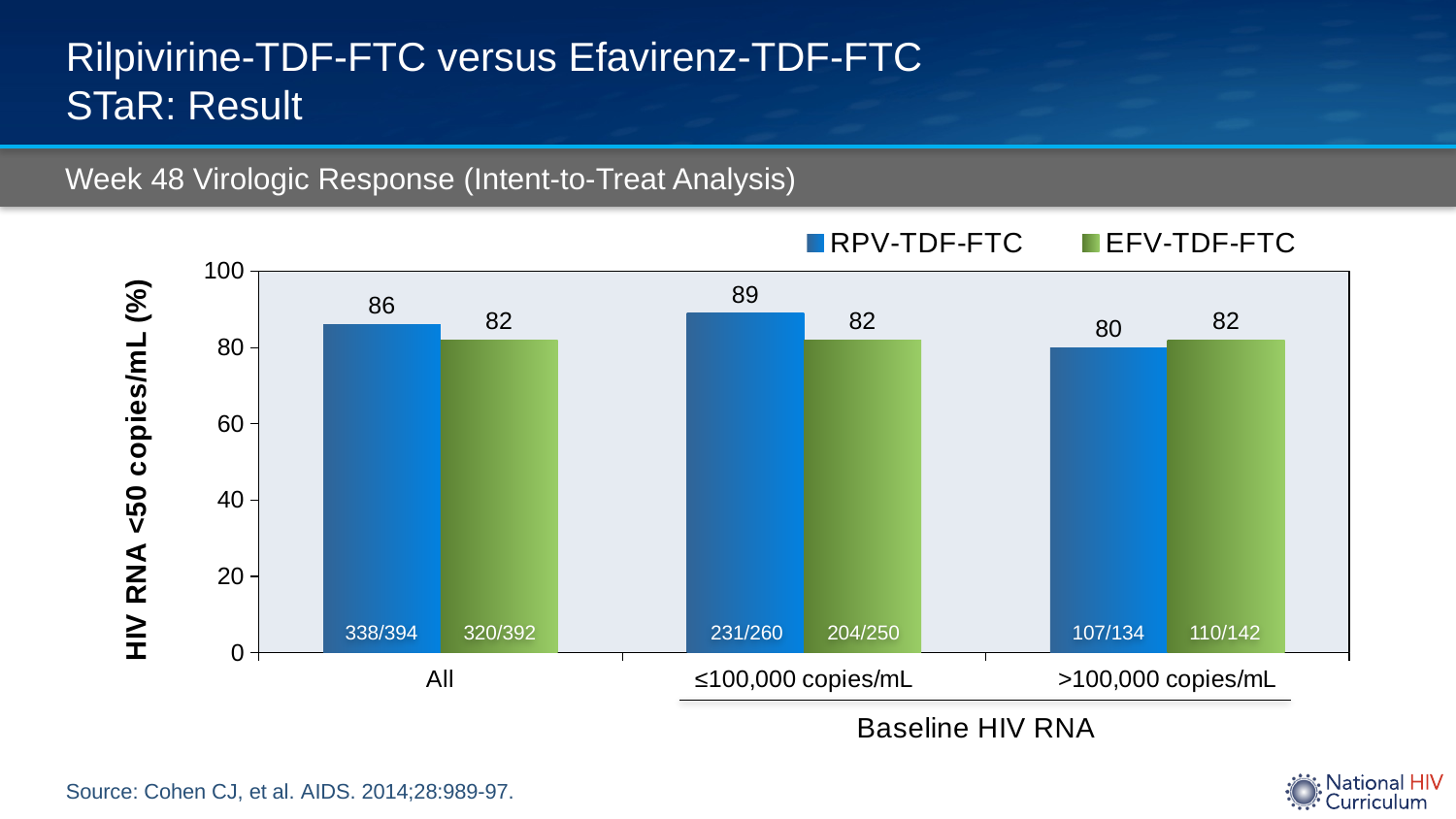
How many series does the legend list? 2 Which category has the lowest value for RPV-TDF-FTC? >100,000 copies/mL What is the difference between the RPV-TDF-FTC and EFV-TDF-FTC values in the ≤100,000 copies/mL category? 7 What is the value for RPV-TDF-FTC in the All category? 86 In the >100,000 copies/mL category, which series has the larger value, RPV-TDF-FTC or EFV-TDF-FTC? EFV-TDF-FTC What is the label of the y axis? HIV RNA <50 copies/mL (%) Which category has the highest value for RPV-TDF-FTC? ≤100,000 copies/mL What fraction is printed inside the RPV-TDF-FTC bar for the All category? 338/394 What kind of chart is shown on the slide? Bar chart How many baseline HIV RNA categories are shown on the x axis? 3 What is the value for RPV-TDF-FTC in the ≤100,000 copies/mL category? 89 What is the value for EFV-TDF-FTC in the >100,000 copies/mL category? 82